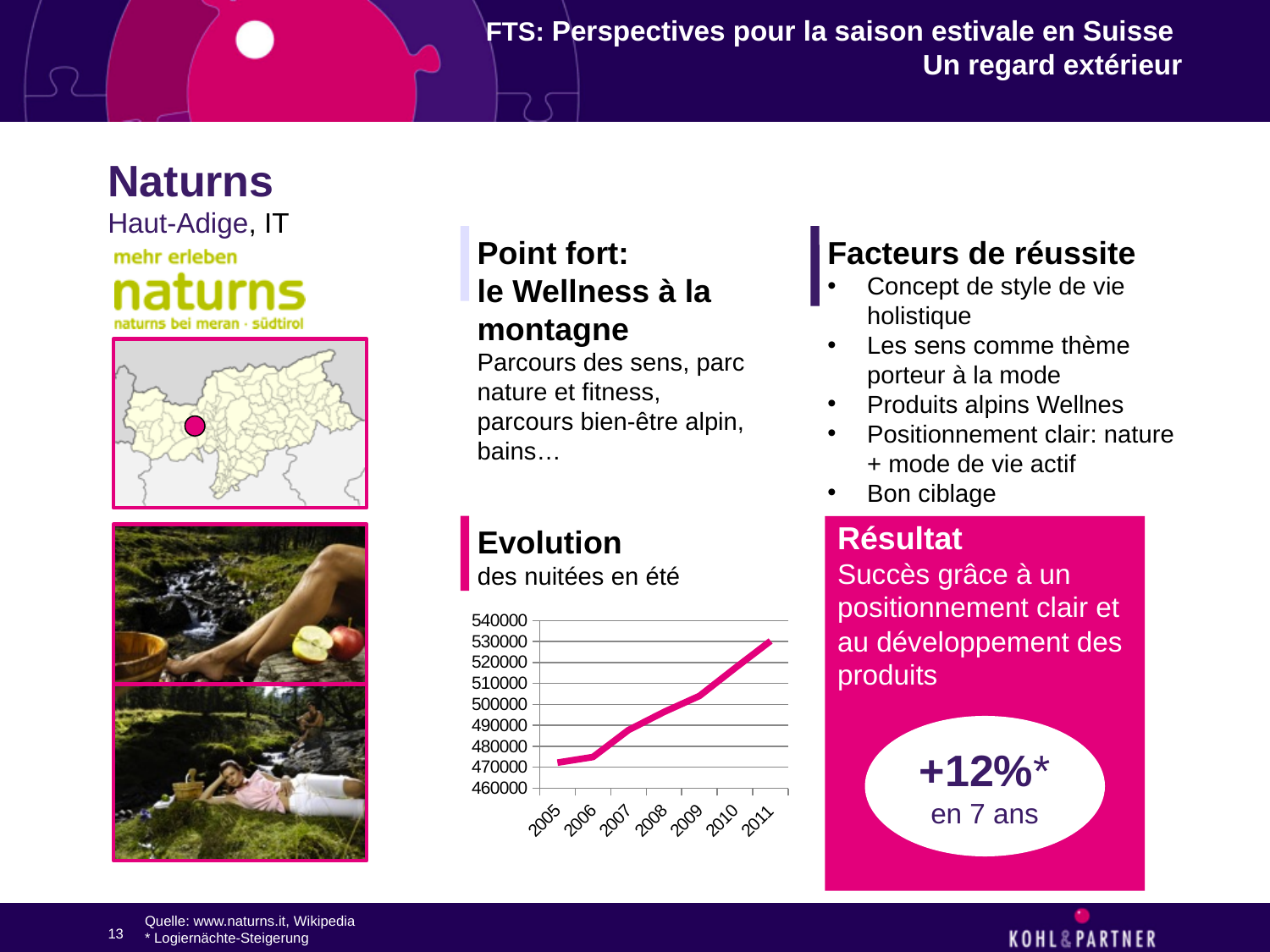
In the 'Evolution des nuitées en été' chart, is the value for 2011 greater or less than 520000? greater In the 'Evolution des nuitées en été' chart, is the value for 2005 greater or less than 480000? less Which year has the lowest value in the 'Evolution des nuitées en été' chart? 2005 Which year has the highest value in the 'Evolution des nuitées en été' chart? 2011 In the 'Evolution des nuitées en été' chart, which year has the larger value, 2005 or 2011? 2011 In the 'Evolution des nuitées en été' chart, is the value for 2010 greater or less than 510000? greater How many years are plotted on the x axis of the 'Evolution des nuitées en été' chart? 7 Do the values in the 'Evolution des nuitées en été' chart rise or fall from 2005 to 2011? rise What is the highest value shown on the y axis of the 'Evolution des nuitées en été' chart? 540000 What kind of chart is shown under the heading 'Evolution des nuitées en été'? line chart What is the first year shown on the x axis of the 'Evolution des nuitées en été' chart? 2005